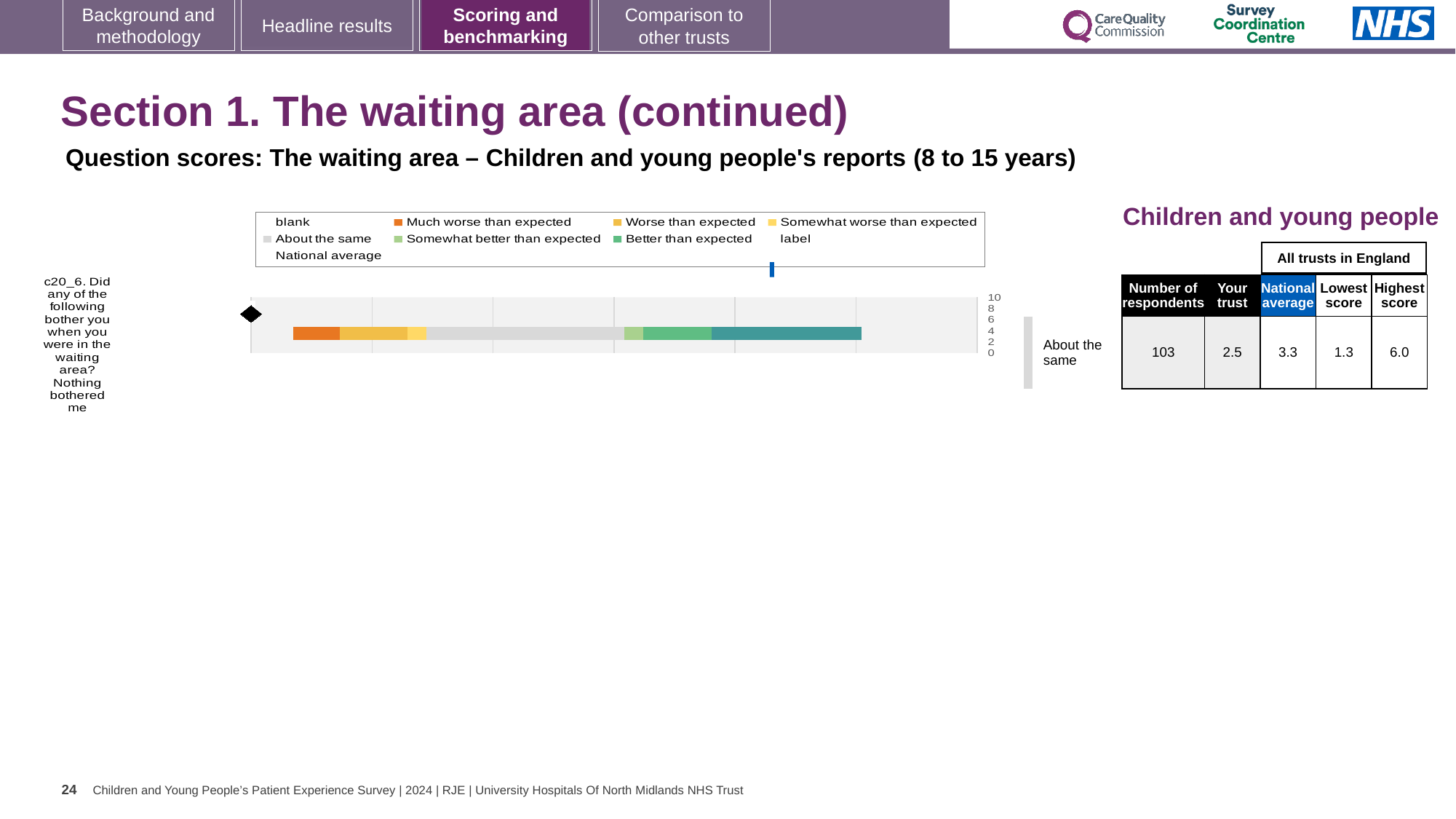
What colour represents 'Much worse than expected' in the chart legend? orange What is the difference between the highest score and the lowest score for question c20_6? 4.7 How many survey questions are plotted in the chart? 1 What is the lowest score among all trusts in England for question c20_6? 1.3 What is the highest score among all trusts in England for question c20_6? 6.0 Which benchmark band is the trust's score for question c20_6 labelled as? About the same What is the 'Your trust' score for question c20_6 in the table? 2.5 What kind of chart is shown on the slide? bar chart Which is larger for question c20_6: the 'Your trust' score or the national average? National average How many entries does the chart legend list? 9 What is the national average score for question c20_6? 3.3 How many respondents answered question c20_6? 103